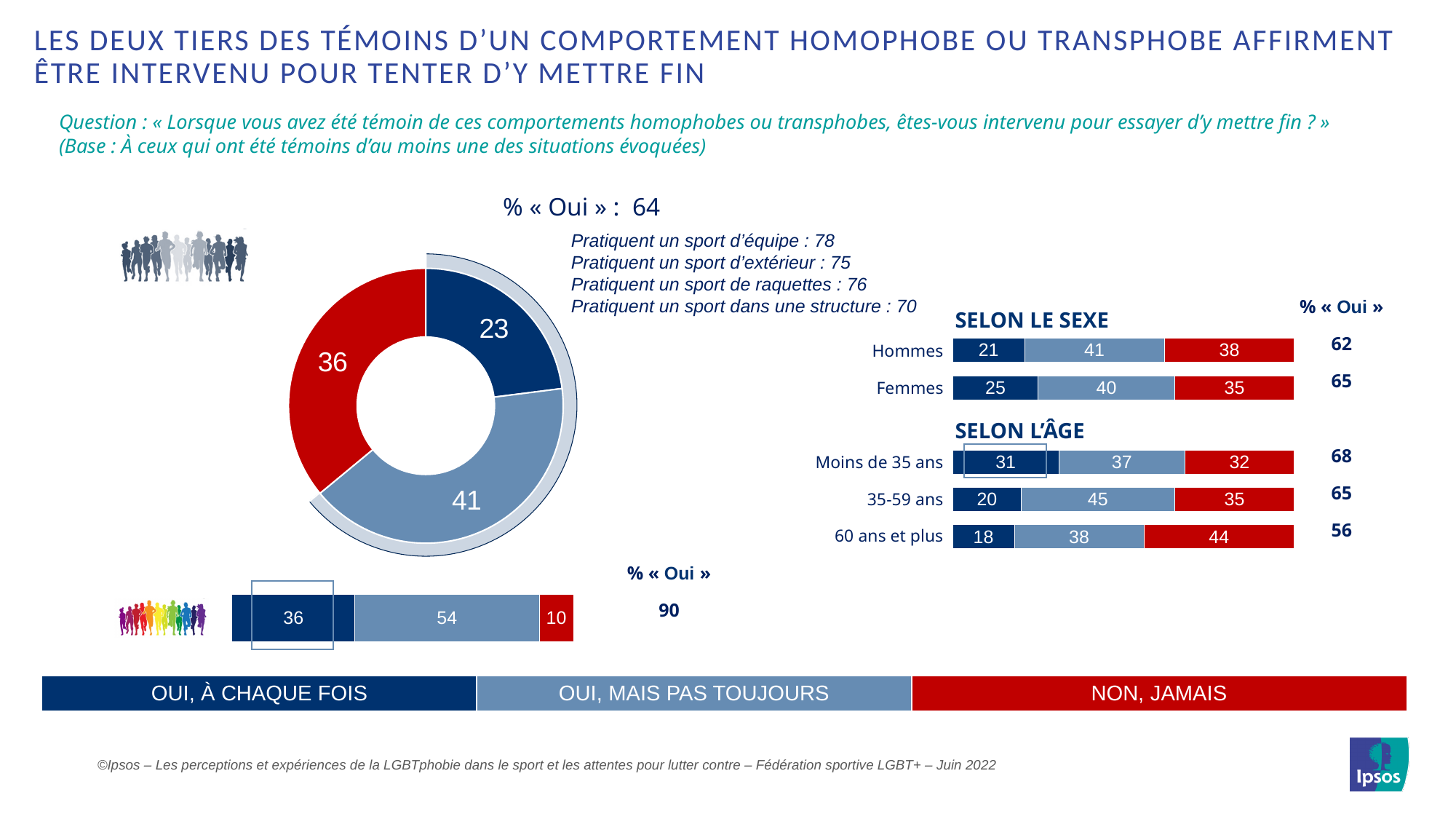
In the donut chart, what percentage answered « Non, jamais »? 36 What type of chart is the chart in the centre-left of the slide showing 23, 41 and 36? Donut (pie) chart How many response categories does the legend at the bottom of the slide list? 3 In the « Selon le sexe » chart, what is the difference between the « Non, jamais » values for Hommes and Femmes? 3 In the stacked bar at the bottom left of the slide (next to the coloured silhouettes), what is the value for « Non, jamais »? 10 In the « Selon l'âge » chart, which age group has the highest « Non, jamais » value? 60 ans et plus In the stacked bar at the bottom left of the slide, what is the total of the three segments (36, 54, 10)? 100 In the « Selon l'âge » chart, which age group has the lowest « Oui, à chaque fois » value? 60 ans et plus In the « Selon l'âge » chart, is the « Oui, mais pas toujours » value larger for 35-59 ans or for Moins de 35 ans? 35-59 ans In the « Selon le sexe » chart, what is the « Oui, mais pas toujours » value for Hommes? 41 In the donut chart, what percentage answered « Oui, à chaque fois »? 23 In the donut chart, which response category has the largest share? Oui, mais pas toujours